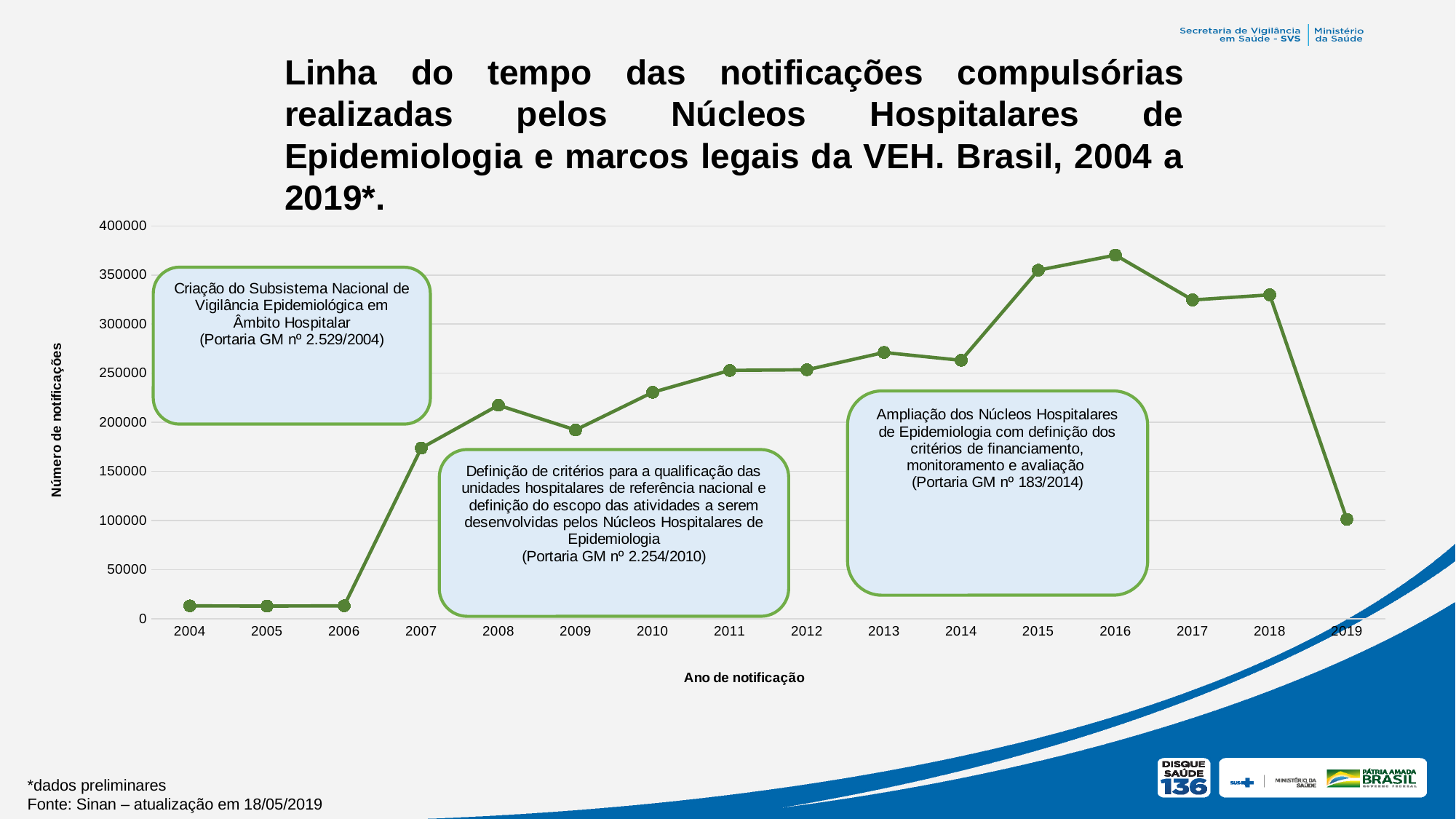
Is the value for 2007 greater or less than 150000? greater What kind of chart is shown on the slide? line chart Is the value for 2009 greater or less than 200000? less Which year has the larger value, 2008 or 2009? 2008 Is the value for 2019 greater or less than 150000? less What is the title of the vertical axis? Número de notificações How many years (data points) are plotted on the x axis? 16 Do the values rise or fall from 2016 to 2019? fall Which year has the highest number of notifications? 2016 Which year has the larger value, 2014 or 2015? 2015